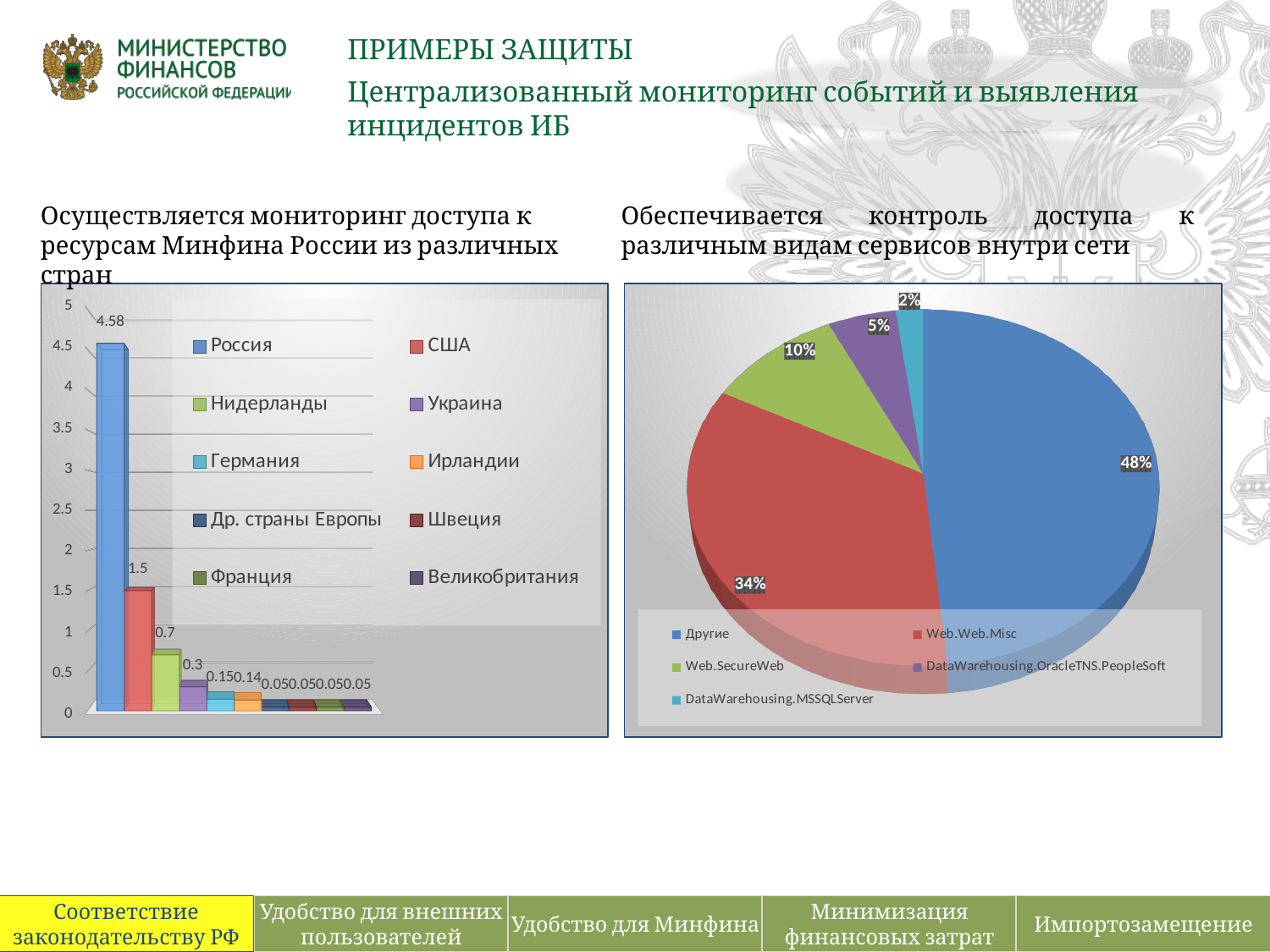
In the pie chart on the right, what share does Web.SecureWeb have? 10% In the left bar chart, which is larger, the value for Нидерланды or the value for Украина? Нидерланды In the pie chart on the right, which category has the smallest share? DataWarehousing.MSSQLServer In the pie chart on the right, what share does Другие have? 48% In the left bar chart, what is the value for Нидерланды? 0.7 What type of chart is shown on the left side of the slide? Bar chart In the left bar chart, which country has the highest value? Россия In the pie chart on the right, how many categories does the legend list? 5 In the left bar chart, what is the difference between the values for Россия and США? 3.08 In the left bar chart, how many series does the legend list? 10 In the left bar chart, what is the value for США? 1.5 In the left bar chart, what is the value for Россия? 4.58